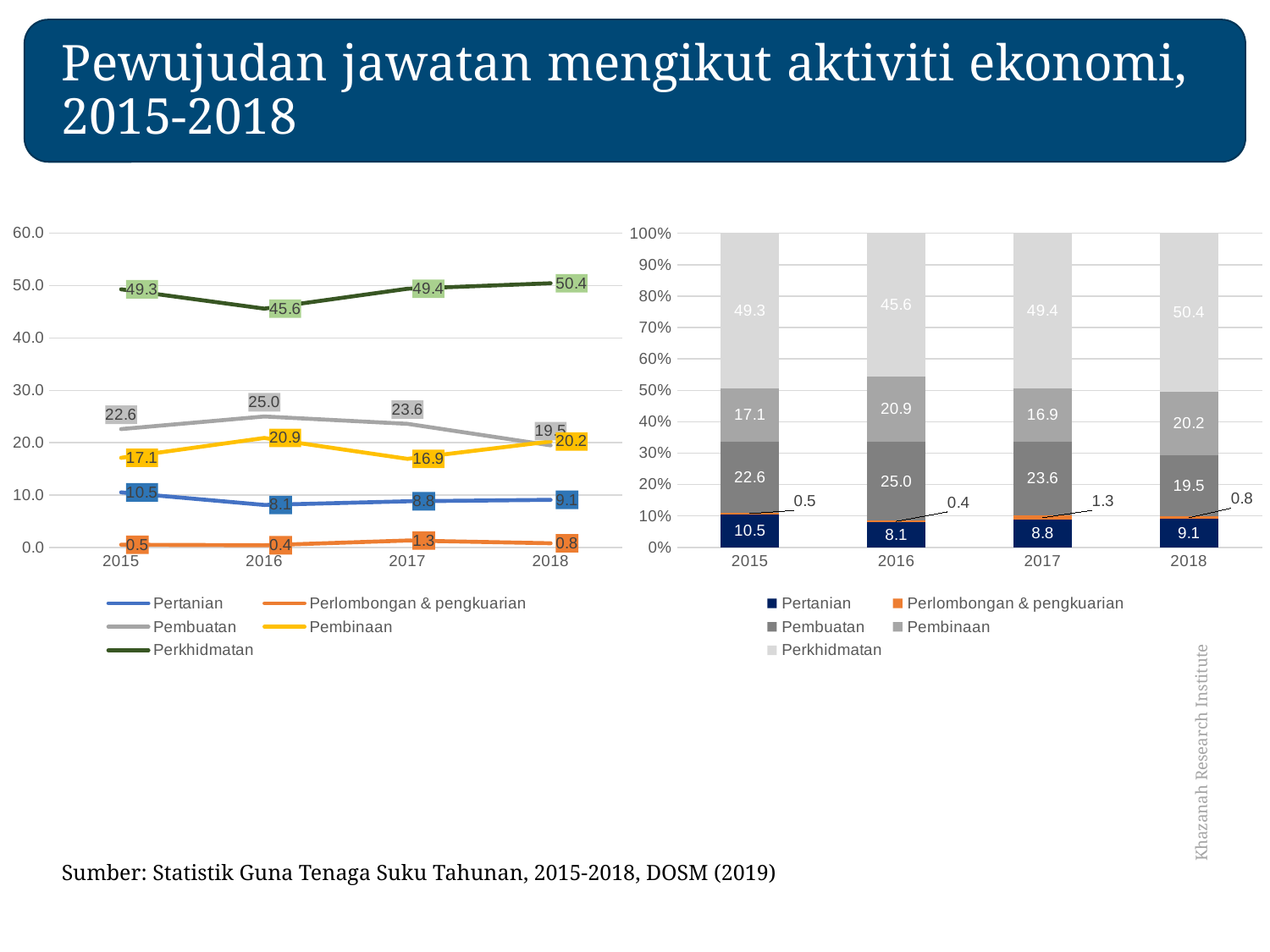
In the line chart on the left, how many series does the legend list? 5 In the stacked bar chart on the right, how many years are shown on the x axis? 4 In the line chart on the left, in which year is the value for Perkhidmatan highest? 2018 In the line chart on the left, what is the value for Perkhidmatan in 2018? 50.4 In the line chart on the left, which is larger in 2018: Pembinaan or Pembuatan? Pembinaan In the stacked bar chart on the right, what is the value for Perlombongan & pengkuarian in 2017? 1.3 What kind of chart is the chart on the right of the slide? bar chart In the stacked bar chart on the right, what is the value for Pembuatan in 2016? 25.0 In the line chart on the left, in which year is the value for Pertanian lowest? 2016 In the line chart on the left, does the value for Pertanian rise or fall from 2016 to 2018? rise In the stacked bar chart on the right, what is the difference between the Pembuatan value in 2016 and in 2018? 5.5 What kind of chart is the chart on the left of the slide? line chart